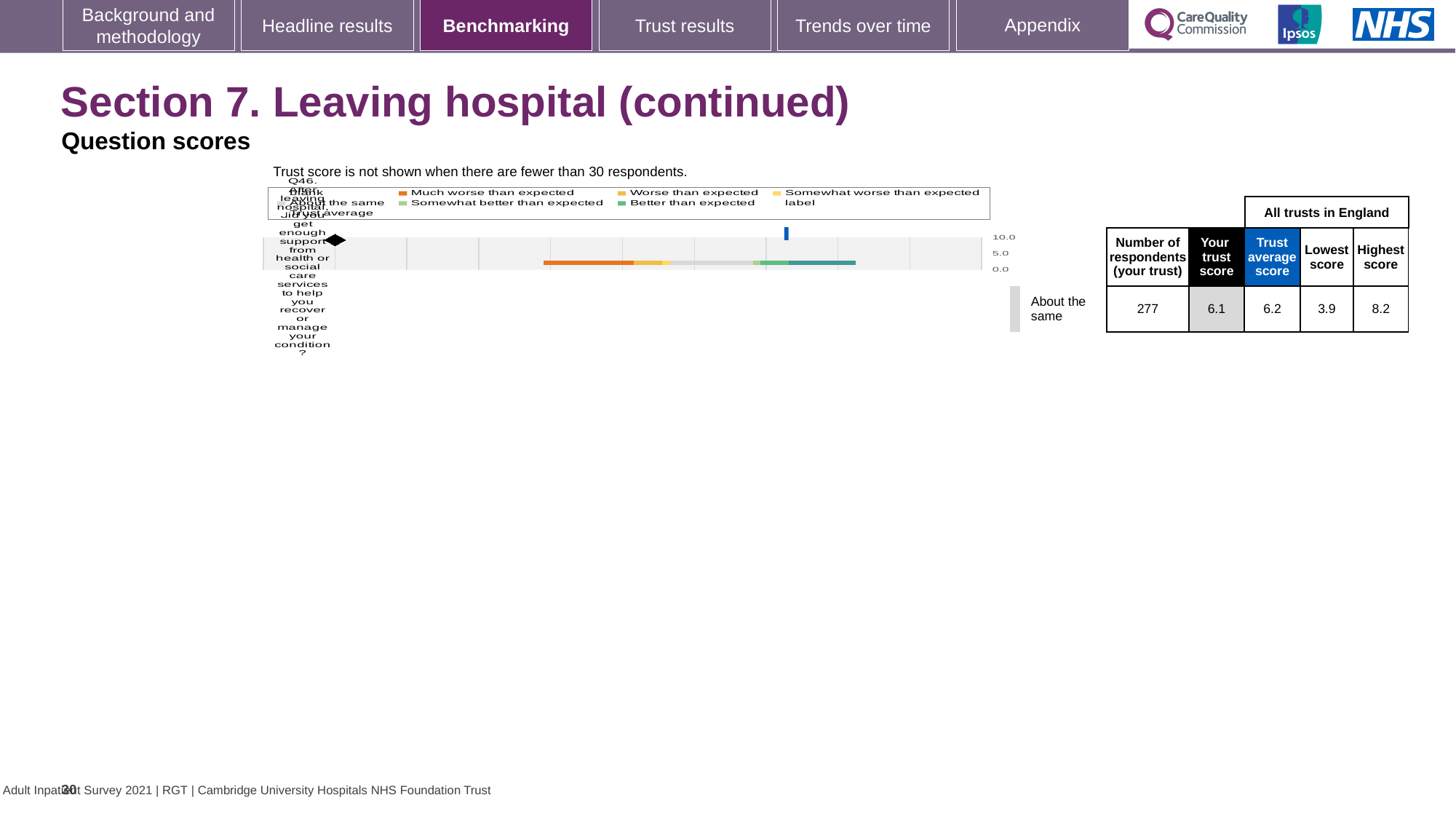
What is the difference between the highest score and the lowest score for Q46? 4.3 Which is larger for Q46: your trust score or the trust average score? trust average score What is the lowest score among all trusts in England for Q46? 3.9 How many questions (categories) are plotted in the chart? 1 What benchmark category is shown for Q46 next to the chart? About the same What is your trust score for Q46? 6.1 Which colour represents 'Much worse than expected' in the chart legend? orange What is the highest score among all trusts in England for Q46? 8.2 What is the trust average score for Q46? 6.2 What is the number of respondents for your trust for Q46? 277 What is the highest value shown on the chart's axis? 10.0 What kind of chart is shown on the slide? bar chart